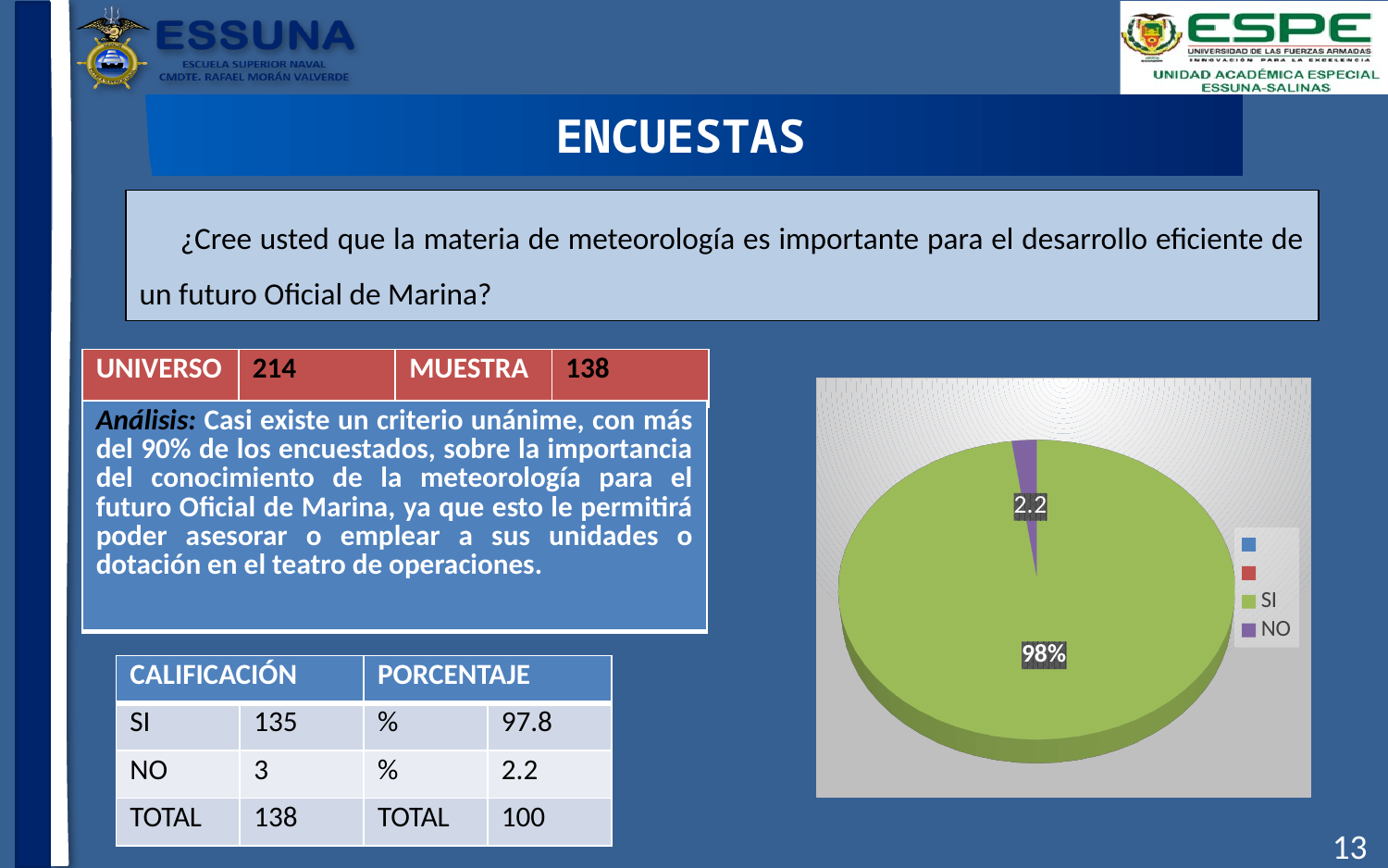
Which category has the largest slice in the pie chart? SI What type of chart is shown on the slide? pie chart How many entries does the legend of the pie chart list? 4 Which category has the smallest slice in the pie chart? NO What colour is the NO slice in the pie chart? purple What value is labelled on the SI slice of the pie chart? 98% What colour is the SI slice in the pie chart? green What value is labelled on the NO slice of the pie chart? 2.2 What share of the pie does the SI slice represent? 98% How many slices are visible in the pie chart? 2 Which slice is larger in the pie chart, SI or NO? SI